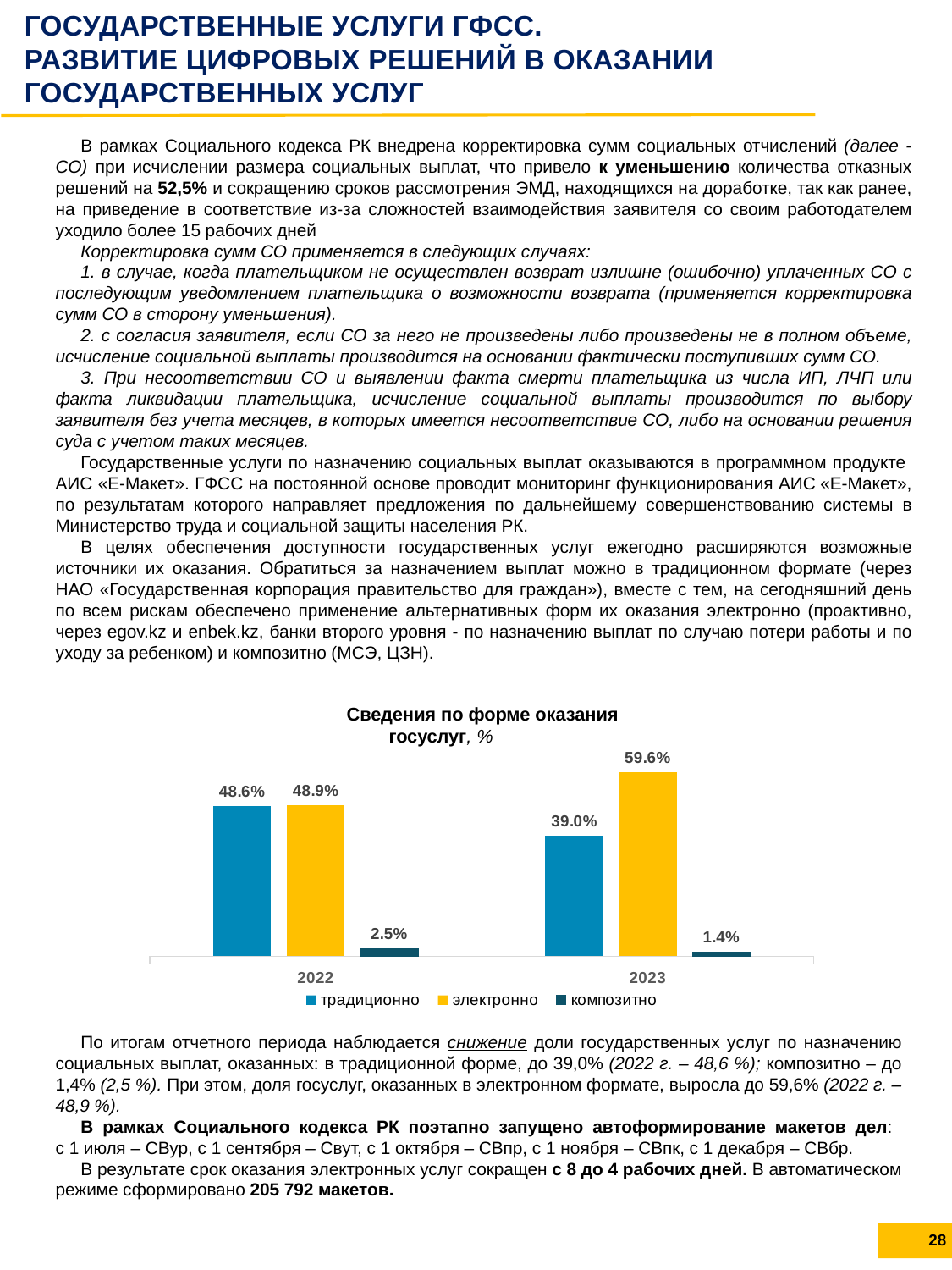
Does the value for композитно rise or fall from 2022 to 2023? fall Which series has the highest value in 2023? электронно What is the value for композитно in 2023? 1.4% What is the value for электронно in 2023? 59.6% Which is larger in 2023: традиционно or электронно? электронно What is the value for электронно in 2022? 48.9% Which series has the lowest value in 2022? композитно How many series does the legend list? 3 What is the difference between the традиционно values for 2022 and 2023? 9.6% What is the difference between электронно and традиционно in 2023? 20.6% What kind of chart is shown? bar chart What is the value for традиционно in 2022? 48.6%